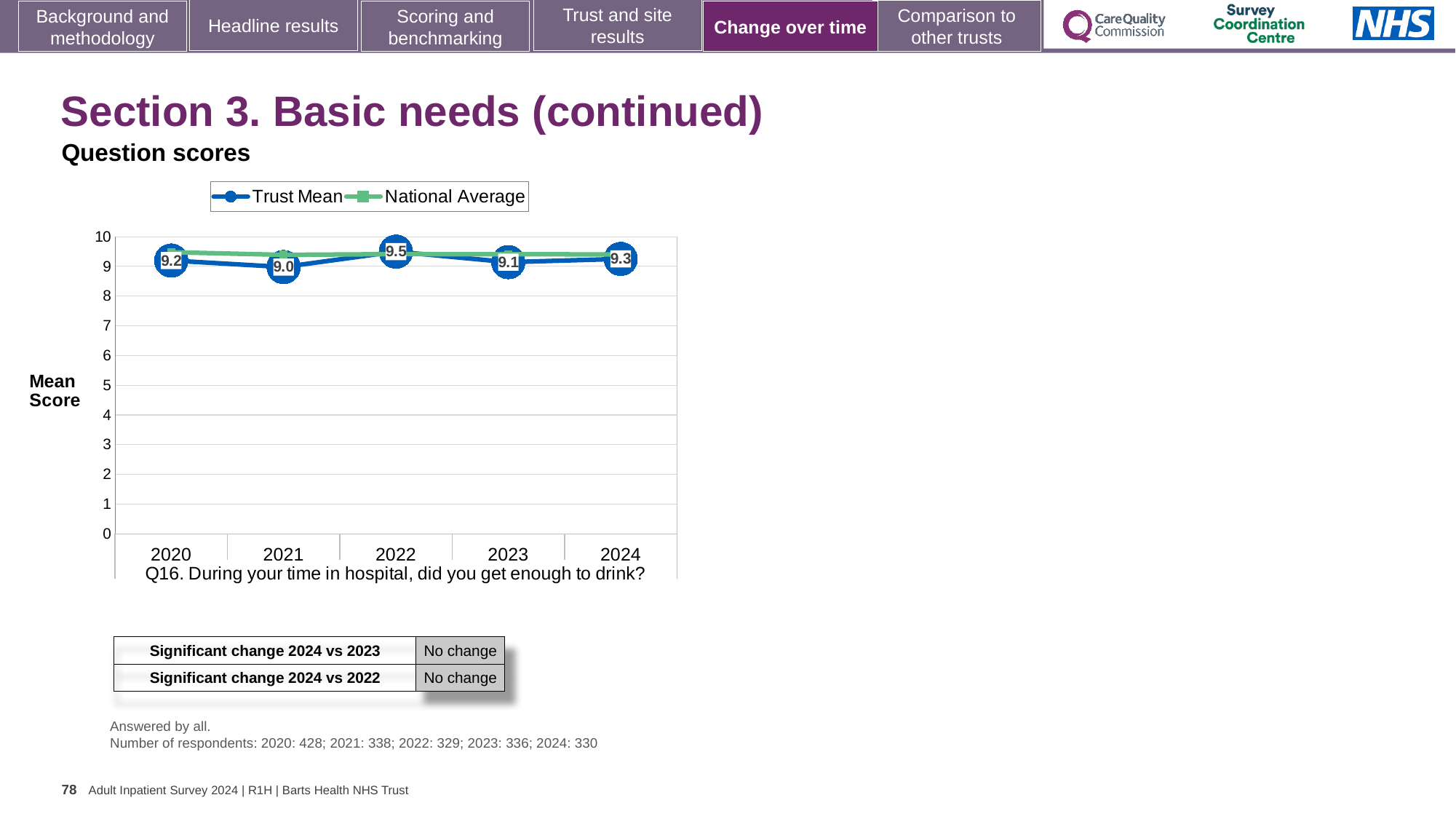
How many series does the legend list? 2 What is the Trust Mean score for 2020? 9.2 What is the difference between the Trust Mean scores for 2022 and 2021? 0.5 What is the Trust Mean score for 2024? 9.3 In which year is the Trust Mean score highest? 2022 What is the Trust Mean score for 2022? 9.5 Is the National Average value for 2022 greater or less than 5? greater How many years are plotted on the x axis? 5 Does the Trust Mean score rise or fall from 2020 to 2021? Fall Which year has the larger Trust Mean score, 2023 or 2024? 2024 What kind of chart is shown on the slide? Line chart In which year is the Trust Mean score lowest? 2021